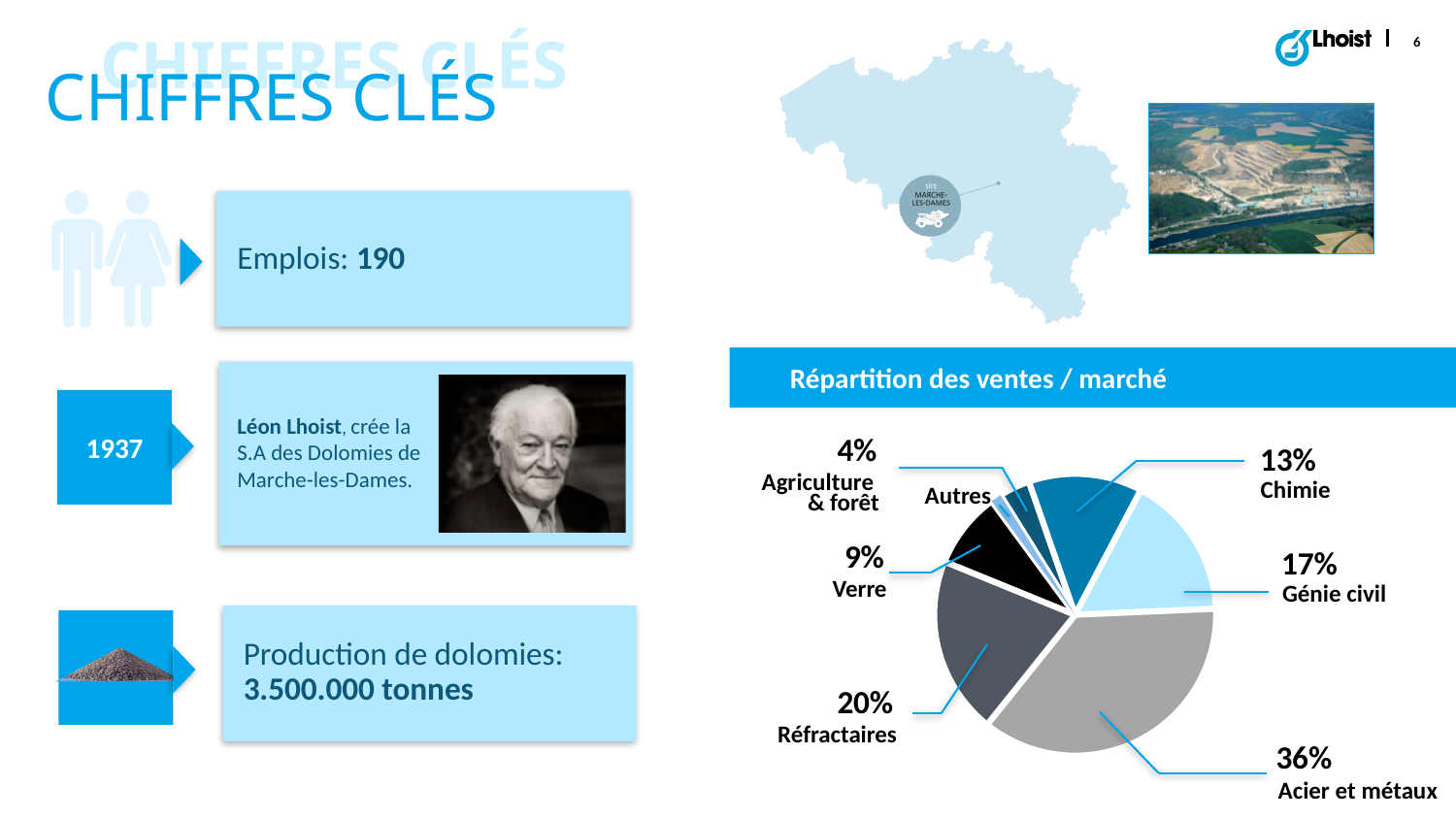
What percentage is shown for 'Génie civil' in the pie chart? 17% What is the difference in percentage points between 'Acier et métaux' and 'Réfractaires' in the pie chart? 16 Which market has the largest share in the pie chart? Acier et métaux What share of sales does 'Acier et métaux' represent in the pie chart? 36% What percentage is shown for 'Verre' in the pie chart? 9% Which has a larger share in the pie chart, 'Génie civil' or 'Chimie'? Génie civil Which of the labelled markets has the smallest printed percentage in the pie chart? Agriculture & forêt What percentage is shown for 'Agriculture & forêt' in the pie chart? 4% What percentage is shown for 'Chimie' in the pie chart? 13% What percentage is shown for 'Réfractaires' in the pie chart? 20% How many slices does the pie chart have? 7 What type of chart is shown under the title 'Répartition des ventes / marché'? pie chart